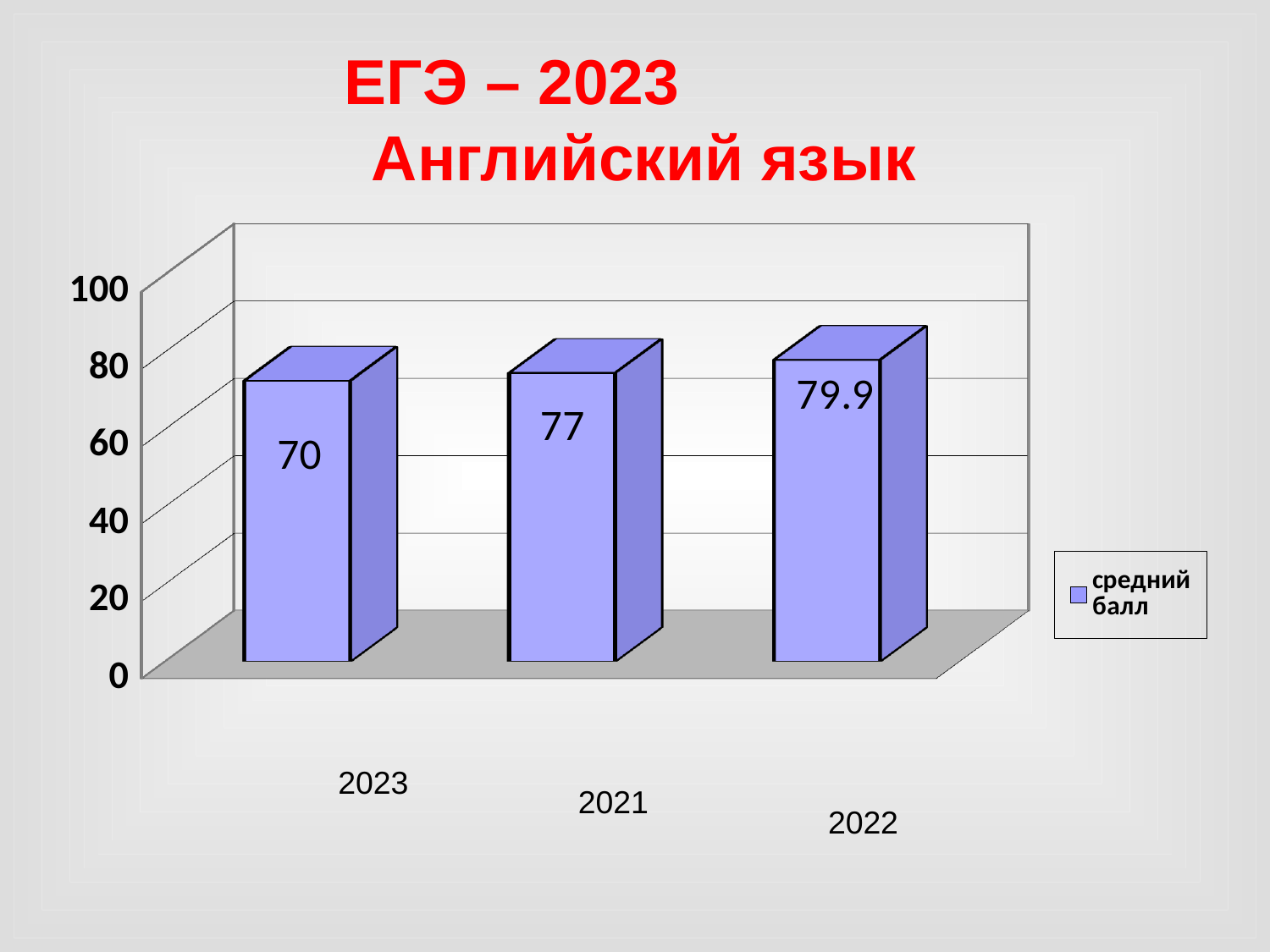
Which year has the highest average score? 2022 What is the average score (средний балл) shown for 2023? 70 What kind of chart is shown on the slide? bar chart What is the average score shown for 2022? 79.9 What is the average score shown for 2021? 77 How many years (bars) are shown in the chart? 3 What is the name of the series in the legend? средний балл How many series does the legend list? 1 Is the value for 2023 greater or less than 80? less What is the difference between the average scores for 2021 and 2023? 7 Which is larger, the average score for 2022 or for 2021? 2022 Which year has the lowest average score? 2023